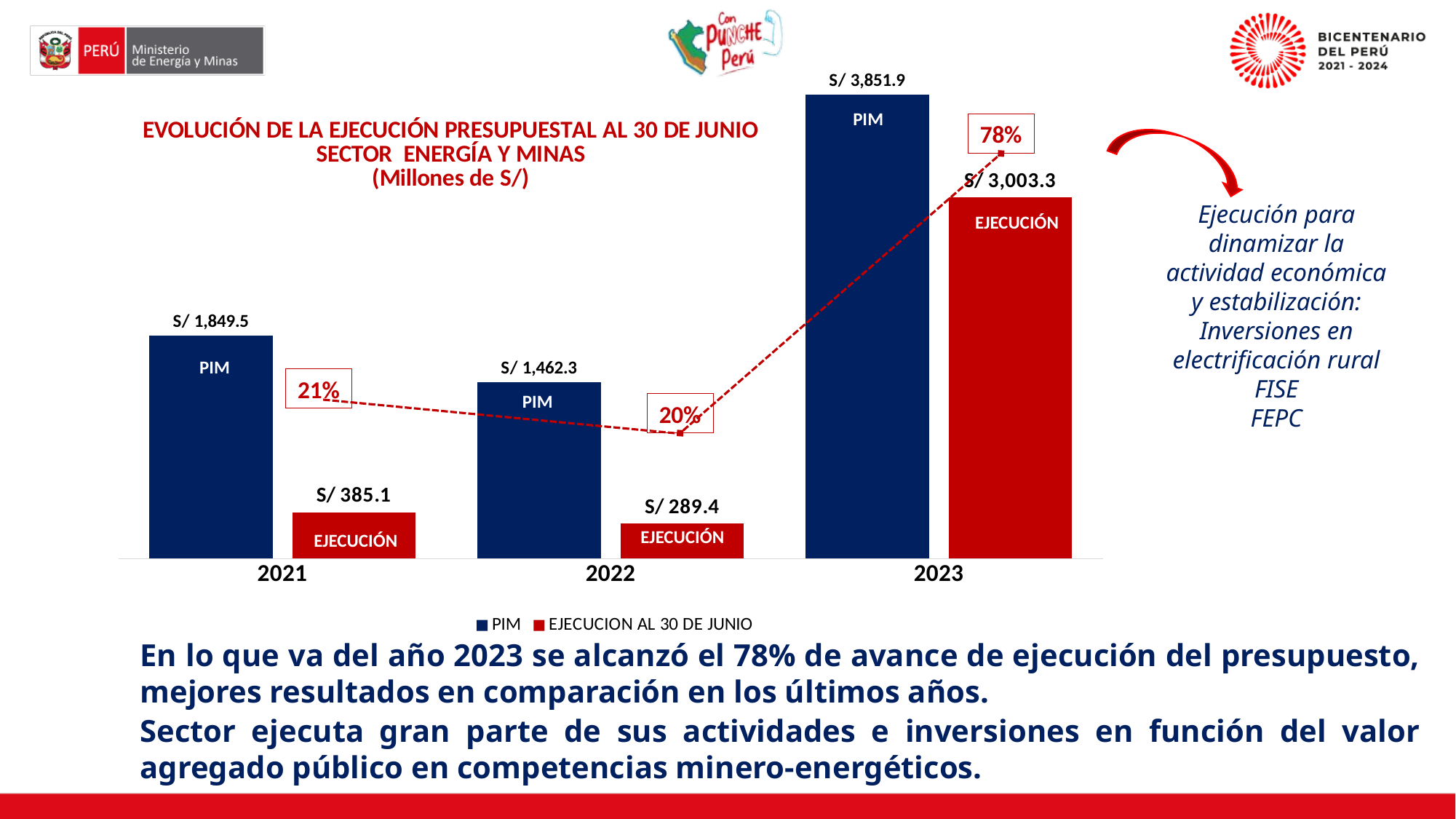
What kind of chart is shown on the slide? Bar chart How many series does the legend list? 2 What is the EJECUCIÓN value for 2023? S/ 3,003.3 Which year has the highest PIM value? 2023 What is the PIM value for 2023? S/ 3,851.9 Which year has the lowest EJECUCIÓN value? 2022 What execution percentage is shown for 2022? 20% What is the EJECUCIÓN value for 2021? S/ 385.1 Which is larger, the PIM for 2021 or the PIM for 2022? PIM for 2021 What is the difference between the EJECUCIÓN values for 2021 and 2022? S/ 95.7 What is the PIM value for 2022? S/ 1,462.3 What is the difference between the PIM values for 2023 and 2022? S/ 2,389.6